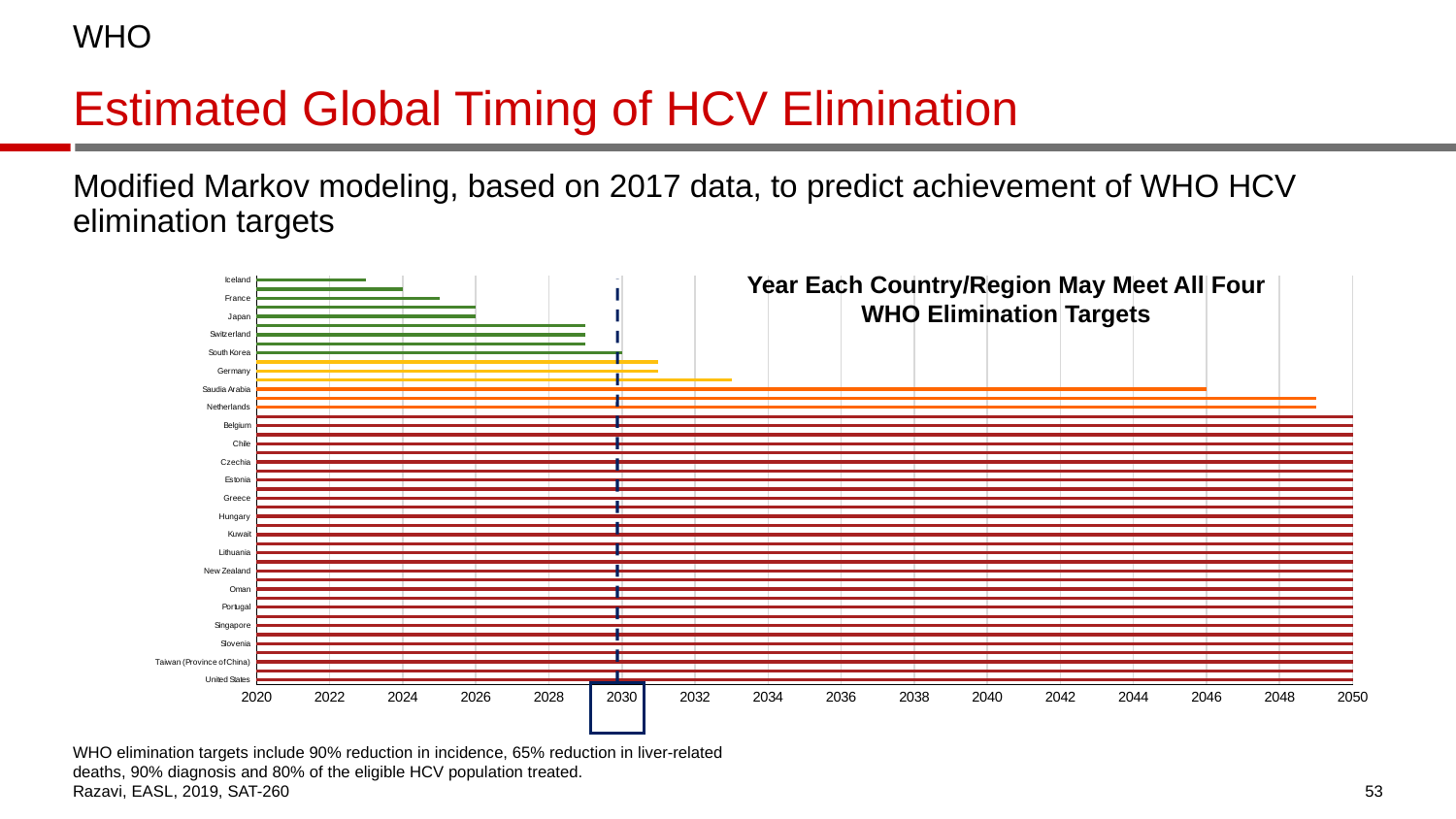
What is the title of the chart? Year Each Country/Region May Meet All Four WHO Elimination Targets What is the first year and the last year shown on the x axis? 2020 and 2050 Is the estimated year for Japan greater or less than 2030? less Which has a later estimated year for meeting the targets, Switzerland or Netherlands? Netherlands Is the estimated year for Saudia Arabia greater or less than 2040? greater Is the estimated year for Belgium greater or less than 2040? greater What kind of chart is shown on the slide? Bar chart Which year on the x axis is marked by the dashed vertical line and highlighted box? 2030 Which country has the earliest estimated year for meeting all four WHO elimination targets? Iceland Which has a later estimated year for meeting the targets, Iceland or the United States? United States